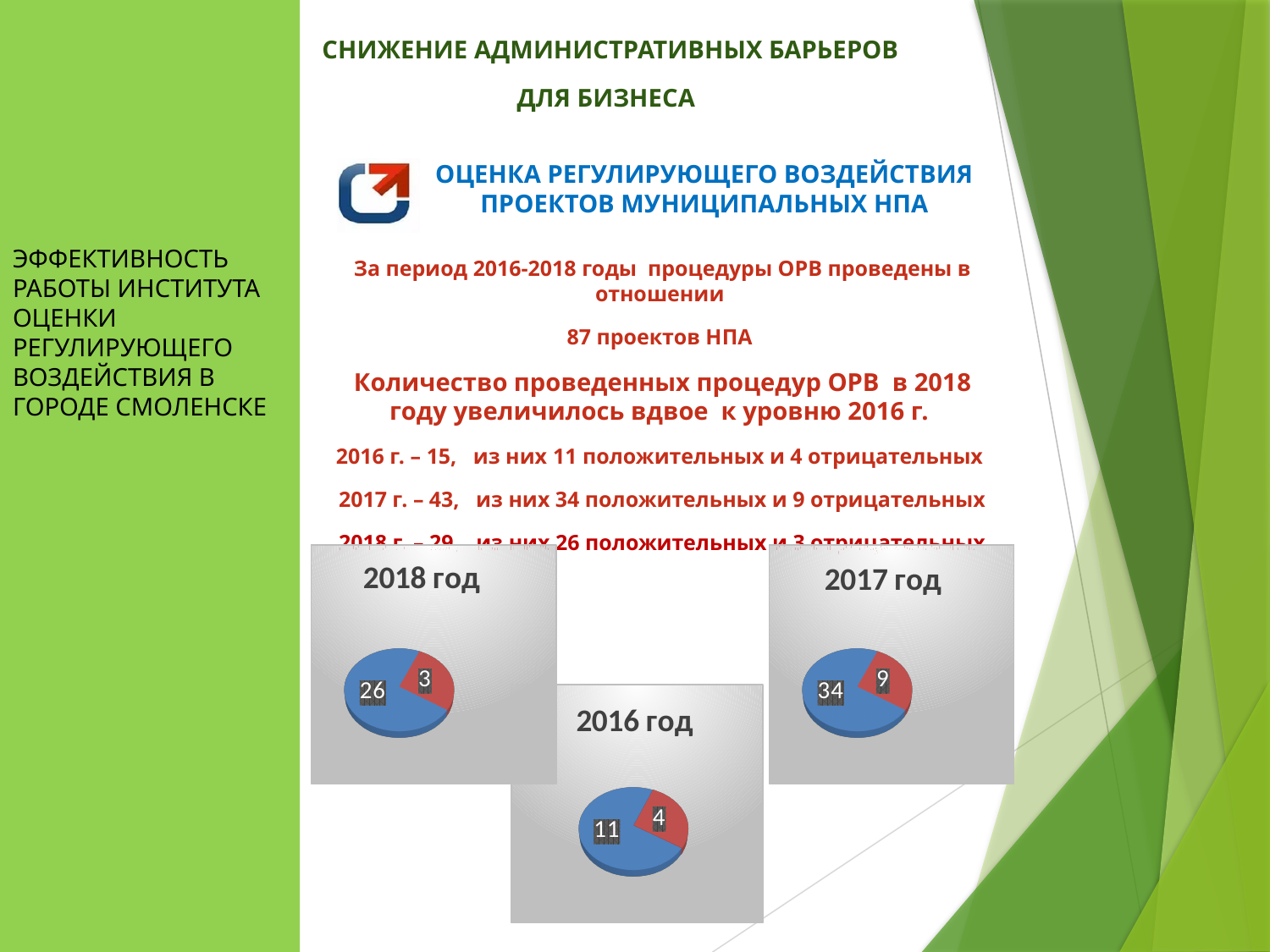
In the "2016 год" pie chart, what value is shown on the red slice? 4 How many pie charts are shown on the slide? 3 In the "2016 год" pie chart, what value is shown on the blue slice? 11 In the "2017 год" pie chart, what is the total of the two slices? 43 In the "2017 год" pie chart, what value is shown on the blue slice? 34 In the "2018 год" pie chart, which slice is larger, the blue one or the red one? the blue one What kind of chart is the "2018 год" chart? pie chart In the "2018 год" pie chart, what value is shown on the blue slice? 26 In the "2016 год" pie chart, what is the difference between the blue slice and the red slice? 7 In the "2018 год" pie chart, what value is shown on the red slice? 3 How many slices does the "2017 год" pie chart have? 2 In the "2017 год" pie chart, what value is shown on the red slice? 9